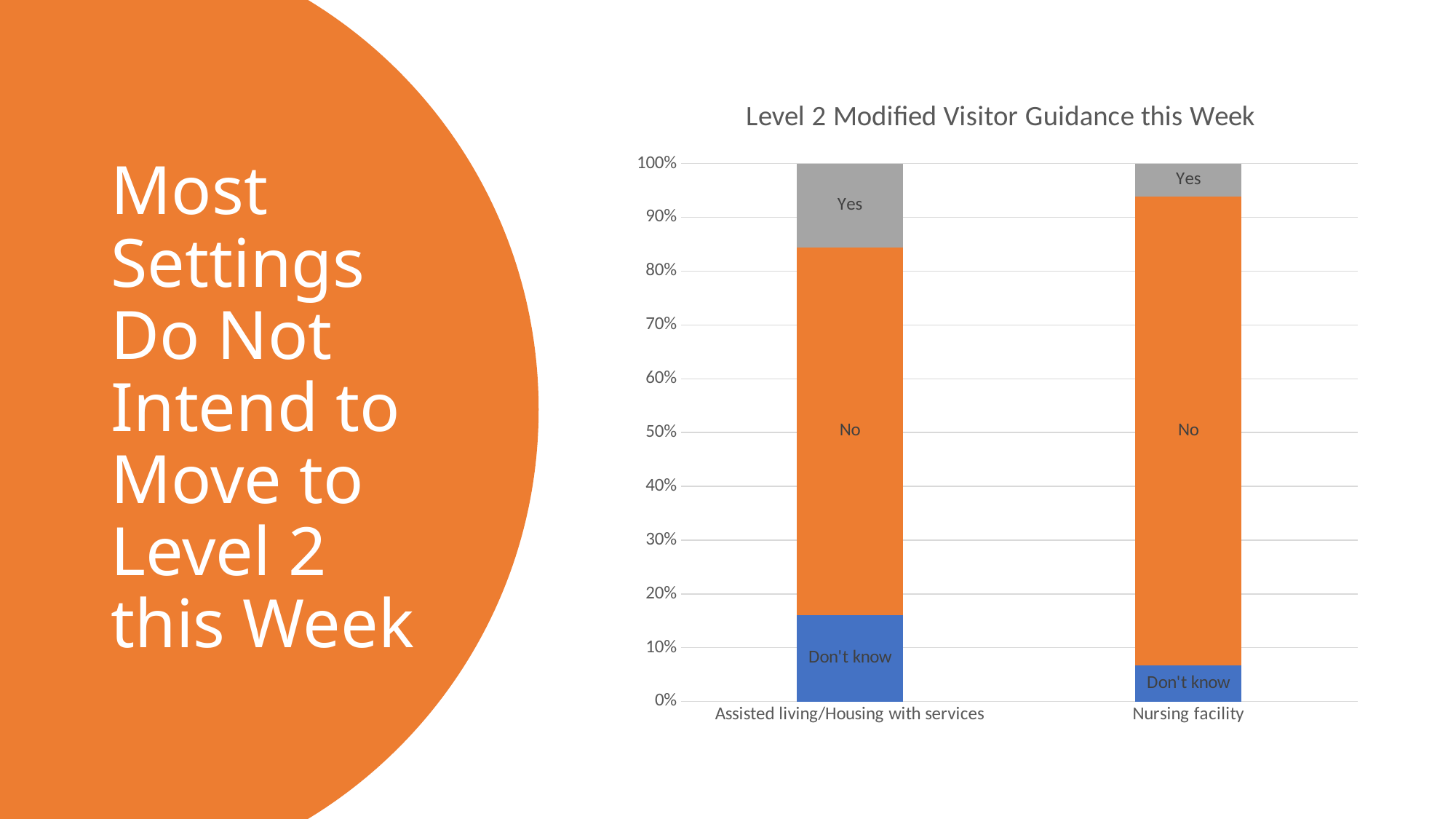
Which segment is the largest in the Assisted living/Housing with services bar? No What is the total height of the stacked bar for Nursing facility? 100% Which category has the larger "Don't know" segment, Assisted living/Housing with services or Nursing facility? Assisted living/Housing with services What is the title of the chart? Level 2 Modified Visitor Guidance this Week What kind of chart is shown on the slide? Stacked bar chart Which category has the larger "Yes" segment, Assisted living/Housing with services or Nursing facility? Assisted living/Housing with services How many response segments (series) make up each stacked bar? 3 Which category has the larger "No" segment, Assisted living/Housing with services or Nursing facility? Nursing facility Is the "Don't know" segment for Assisted living/Housing with services greater or less than 10%? greater Is the "Don't know" segment for Nursing facility greater or less than 10%? less How many categories are shown on the x axis of the chart? 2 Is the "No" segment for Nursing facility greater or less than 80%? greater